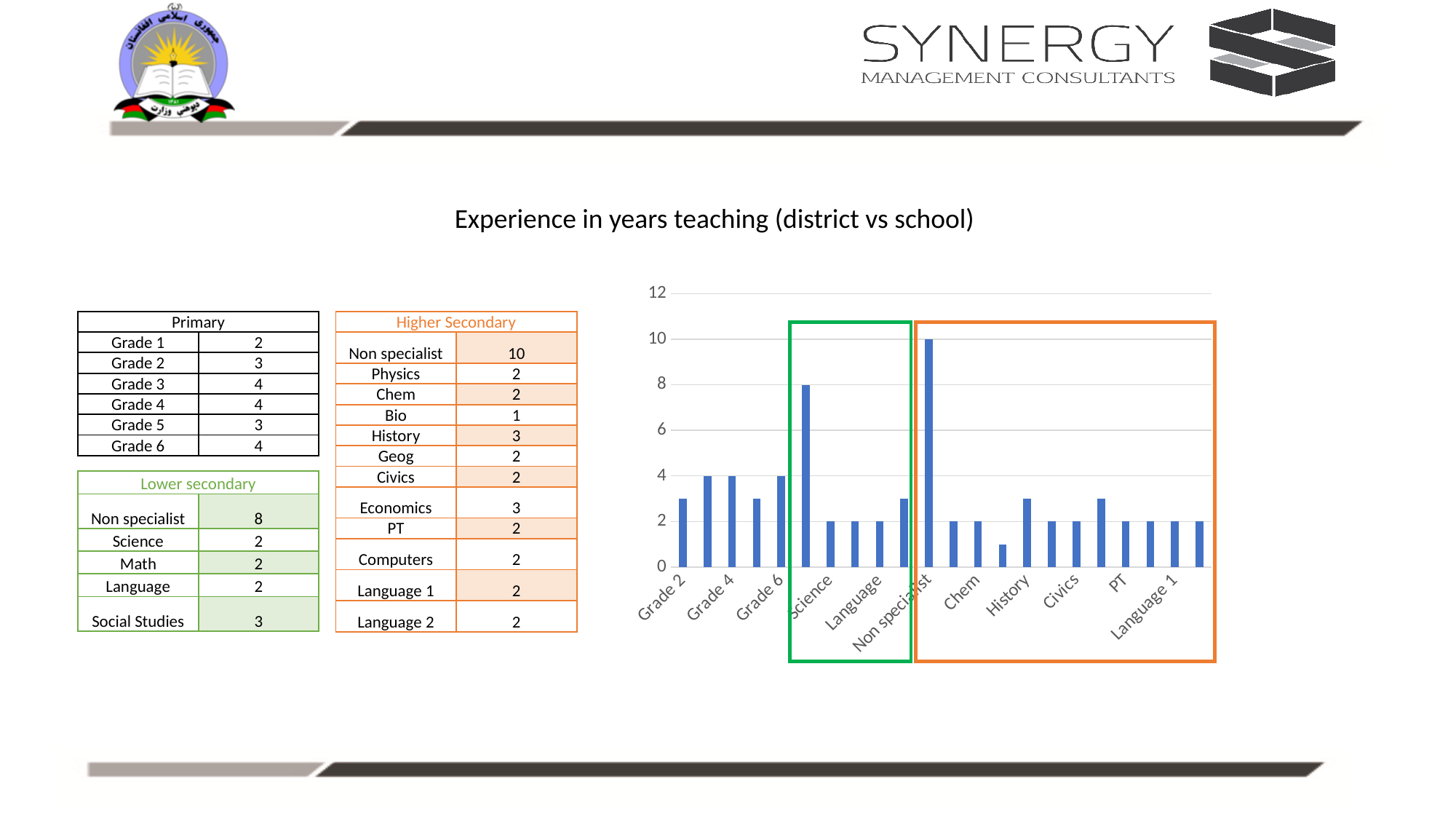
What is the highest value shown on the vertical axis of the chart? 12 What is the title of the chart? Experience in years teaching (district vs school) What kind of chart is shown on the slide? bar chart Which is larger, the value for Grade 6 or the value for Chem? Grade 6 Is the value for the Higher Secondary Non specialist bar greater or less than 8? greater What is the value for Grade 4? 4 What is the value for Science? 2 What is the difference between the Higher Secondary Non specialist value and the Grade 4 value? 6 Is the value for Civics greater or less than 4? less What is the value for History? 3 What is the value for Non specialist in the Higher Secondary group? 10 Which category has the tallest bar in the chart? Non specialist (Higher Secondary)